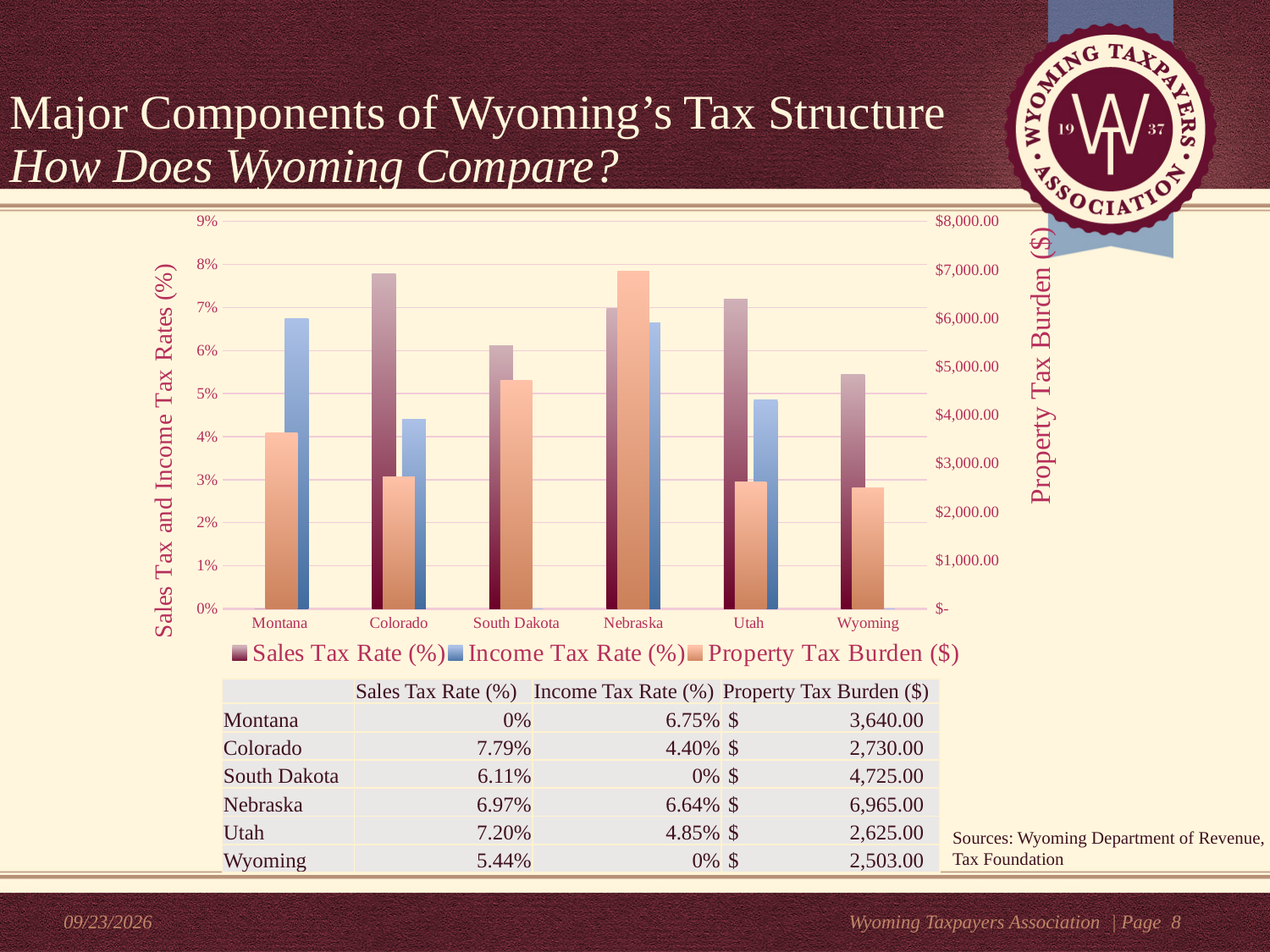
Which state has the highest Sales Tax Rate (%)? Colorado How many states are shown on the x axis of the chart? 6 What is the Income Tax Rate (%) for Wyoming? 0% What is the Sales Tax Rate (%) for Wyoming? 5.44% How many series does the chart legend list? 3 Which state has the highest Property Tax Burden ($)? Nebraska What is the difference between Colorado's and Wyoming's Sales Tax Rate (%)? 2.35% Which is larger, Utah's Sales Tax Rate (%) or Nebraska's Sales Tax Rate (%)? Utah Which state has the lowest Property Tax Burden ($)? Wyoming What is the Income Tax Rate (%) for Montana? 6.75% What kind of chart is shown on the slide? Bar chart What is the Property Tax Burden ($) for Nebraska? $6,965.00